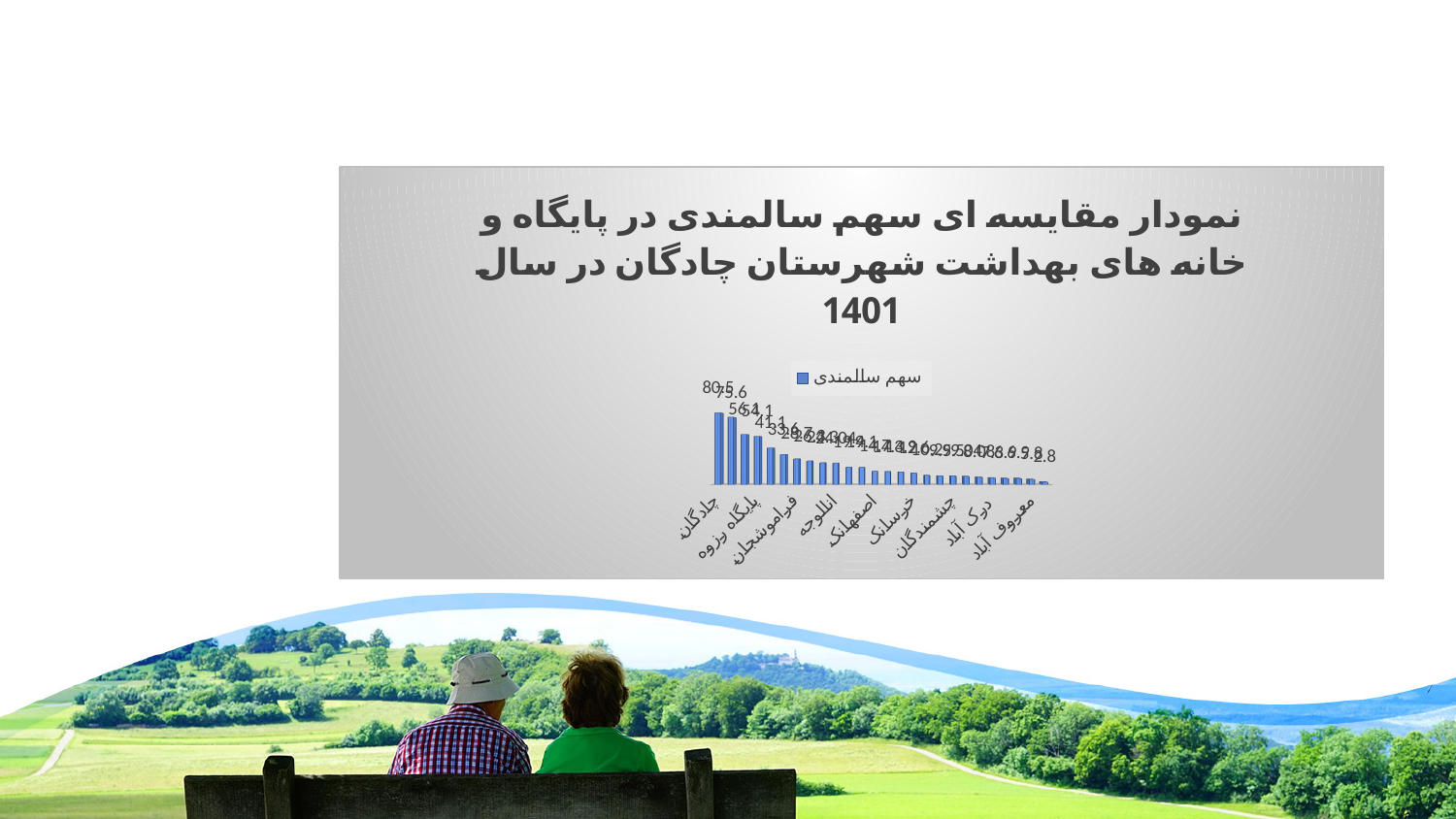
Which category has the highest value in the chart? چادگان What year is mentioned in the chart title? 1401 Which has a larger value, انالوجه or چشمندگان? انالوجه Which has a larger value, چادگان or معروف آباد? چادگان Which has a larger value, فراموشجان or درک آباد? فراموشجان What kind of chart is shown on the slide? bar chart Do the values rise or fall moving from left to right along the x axis? fall What is the name of the series shown in the chart legend? سهم سالمندی How many series does the chart legend list? 1